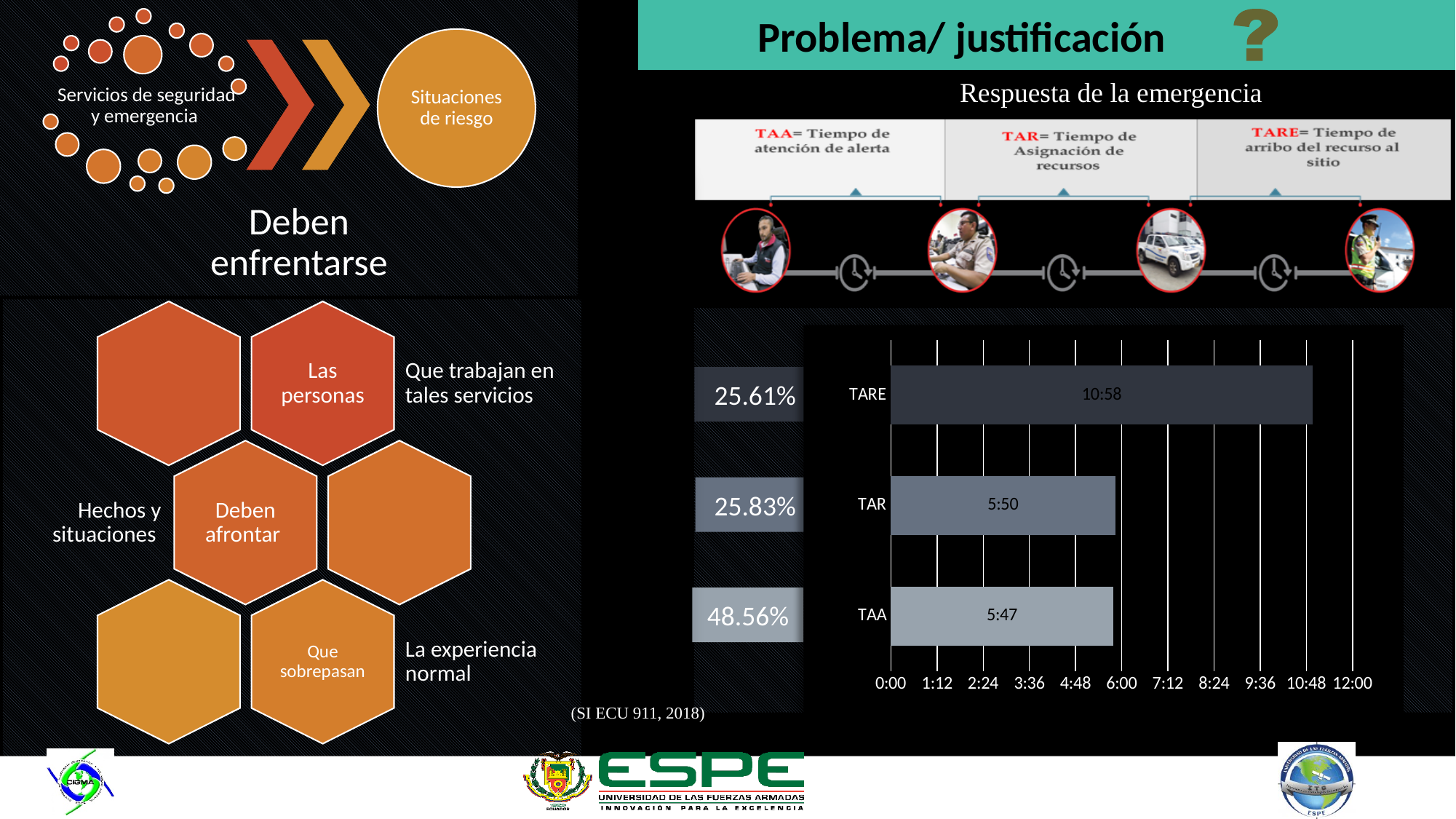
What is the value shown for TAA in the bar chart? 5:47 Which category has the highest value in the bar chart? TARE What is the value shown for TARE in the bar chart? 10:58 What is the highest tick value shown on the x axis of the bar chart? 12:00 Which category has the lowest value in the bar chart? TAA Is the value for TARE greater or less than 9:36? greater What type of chart is shown on the right side of the slide? bar chart What is the value shown for TAR in the bar chart? 5:50 How many categories are plotted in the bar chart? 3 Which is larger in the bar chart, the value for TARE or the value for TAR? TARE Is the value for TAA greater or less than 7:12? less What is the difference between the TARE value and the TAR value in the bar chart? 5:08